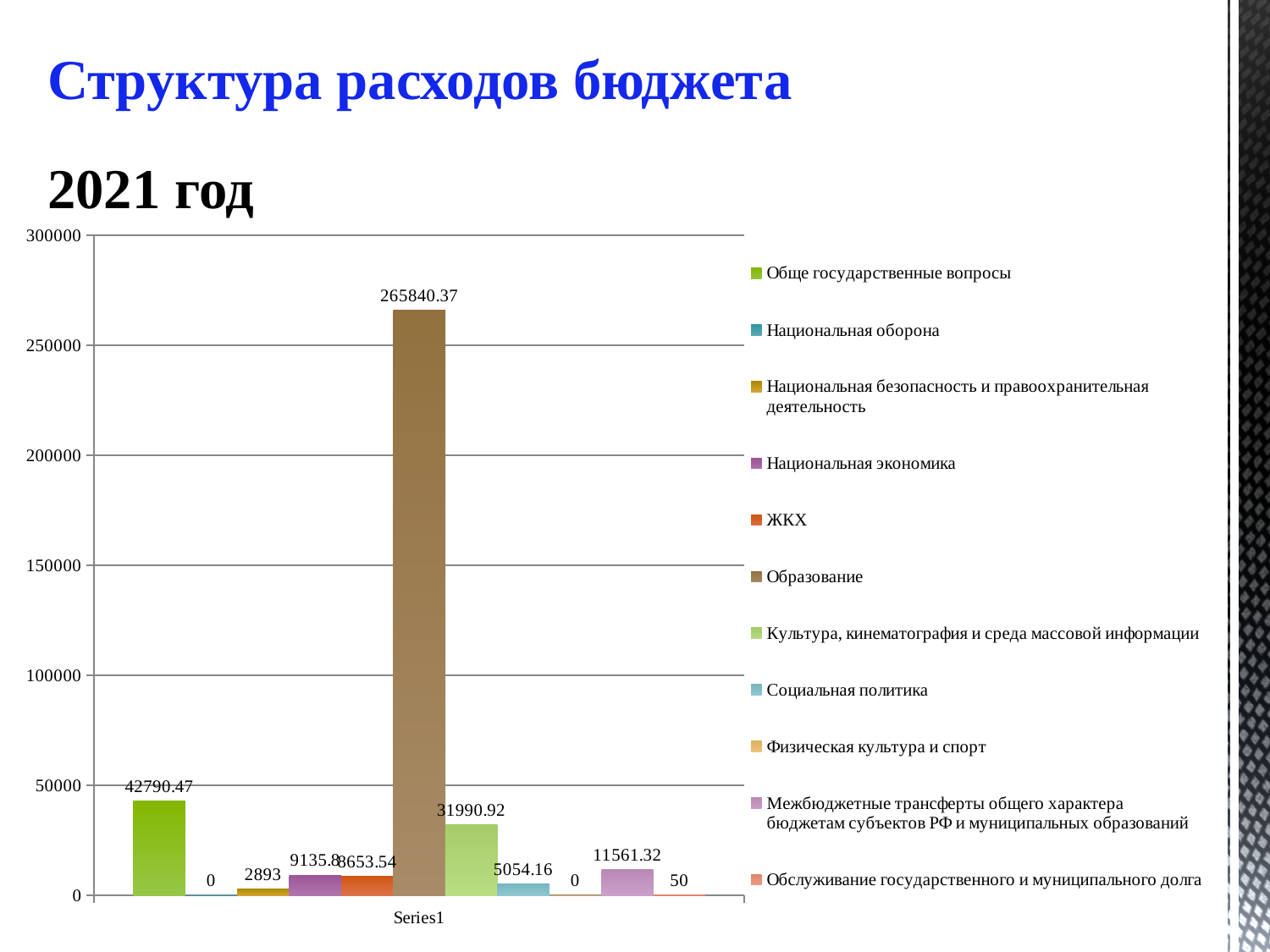
What is the value for Межбюджетные трансферты общего характера бюджетам субъектов РФ и муниципальных образований? 11561.32 What is the value for Образование? 265840.37 Which category has the highest value? Образование Is the value for Образование greater or less than 250000? greater What is the value for Обще государственные вопросы? 42790.47 What is the value for Социальная политика? 5054.16 What is the value for Обслуживание государственного и муниципального долга? 50 How many entries does the legend list? 11 Which is larger, Обще государственные вопросы or Культура, кинематография и среда массовой информации? Обще государственные вопросы What kind of chart is shown on the slide? bar chart What is the difference between the values for Образование and Обще государственные вопросы? 223049.9 What is the value for Культура, кинематография и среда массовой информации? 31990.92